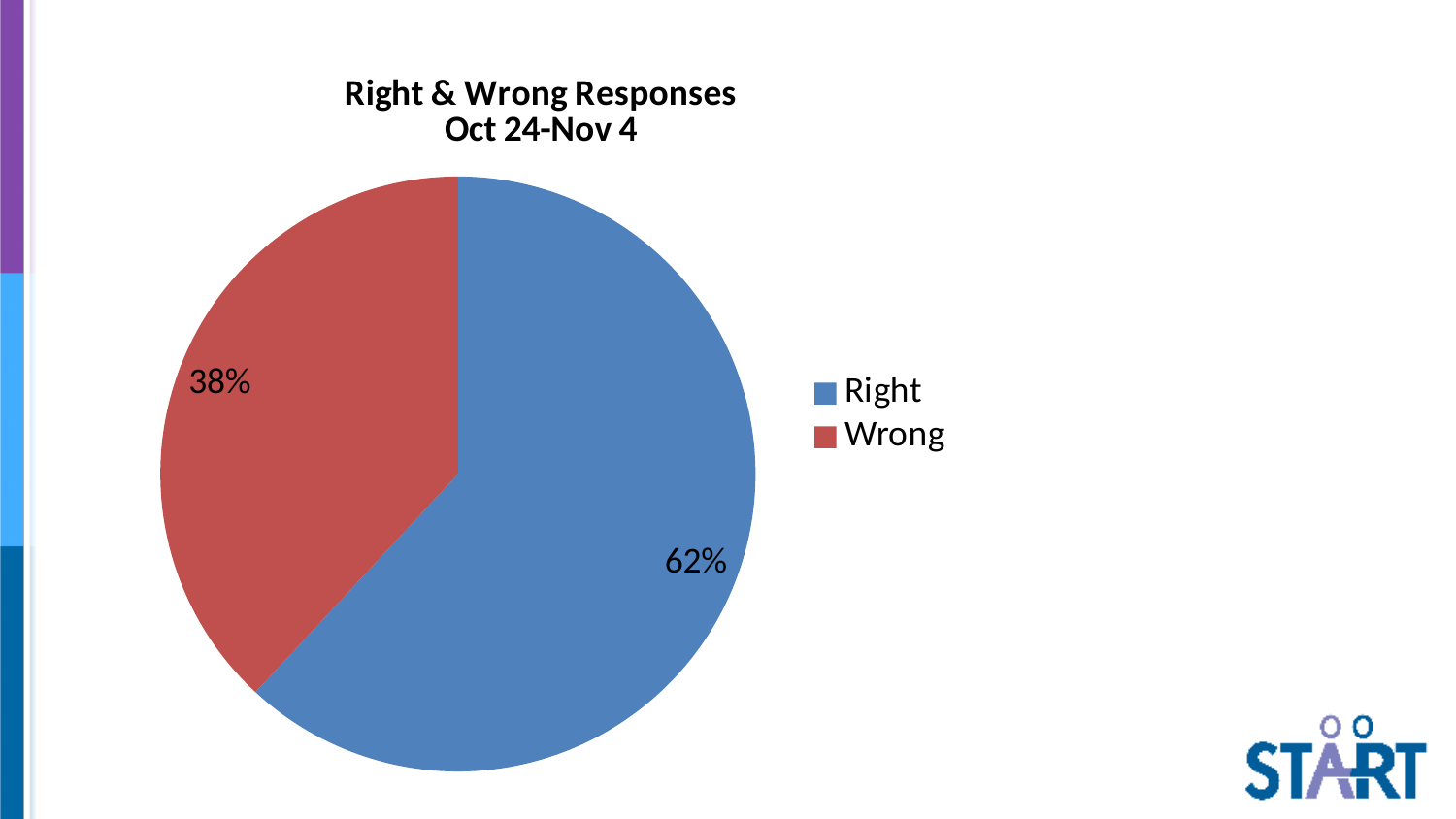
What is the title of the chart? Right & Wrong Responses Oct 24-Nov 4 How many entries does the legend list? 2 What colour is the Wrong slice? red What percentage of responses were Wrong? 38% Which category has the smallest share of the pie? Wrong What percentage of responses were Right? 62% How many categories does the pie chart have? 2 What kind of chart is shown on the slide? pie chart What is the difference in percentage points between Right and Wrong responses? 24 Which category has the largest share of the pie? Right Which is larger, the share of Right responses or the share of Wrong responses? Right What share of the pie does the Right slice take? 62%